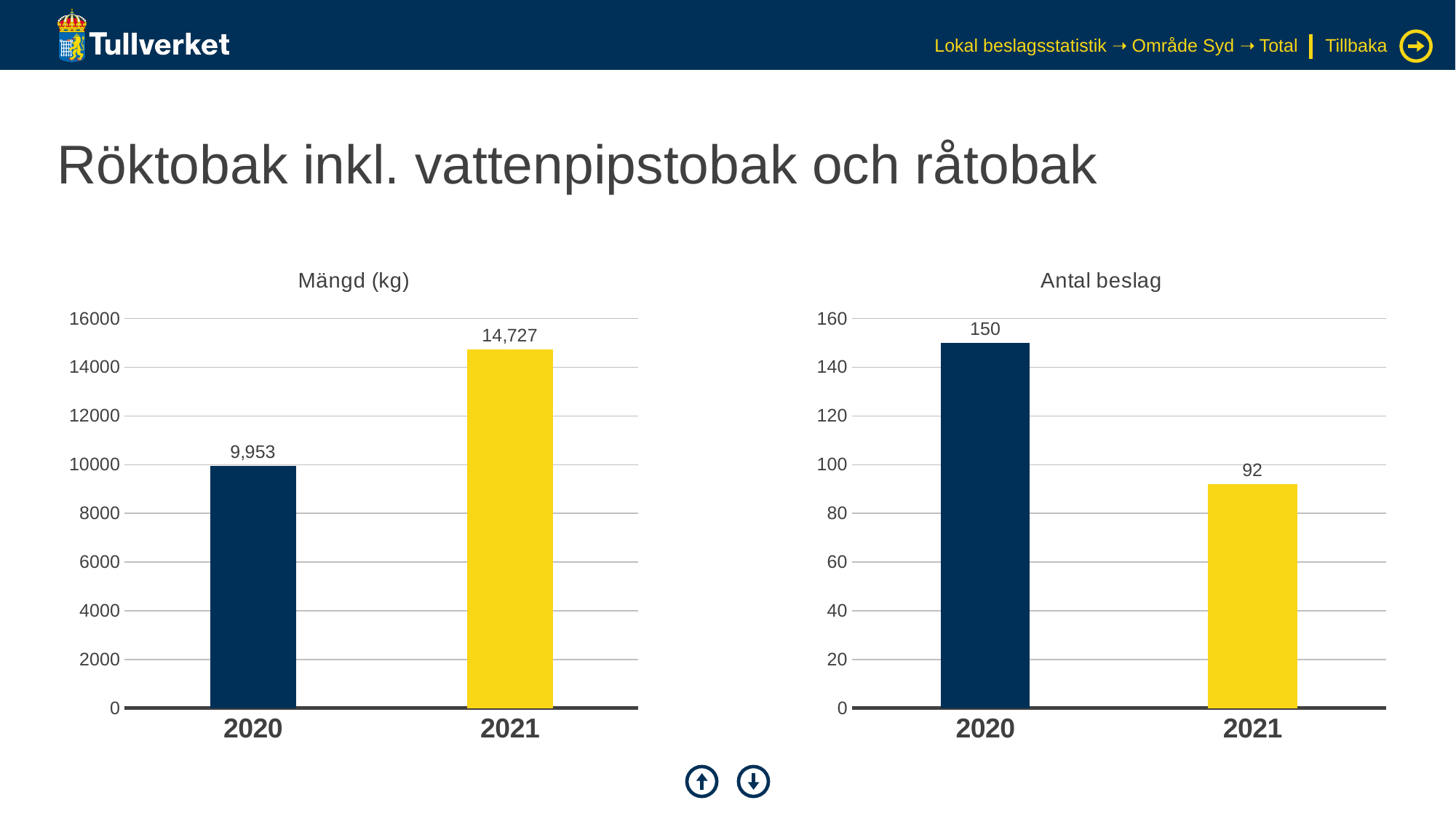
In the 'Antal beslag' chart, what is the value for 2020? 150 In the 'Mängd (kg)' chart, what is the value for 2020? 9,953 In the 'Mängd (kg)' chart, do the values rise or fall from 2020 to 2021? rise In the 'Antal beslag' chart, what is the value for 2021? 92 In the 'Mängd (kg)' chart, what is the value for 2021? 14,727 In the 'Antal beslag' chart, which year has the lowest value? 2021 In the 'Antal beslag' chart, what is the difference between the 2020 and 2021 values? 58 In the 'Mängd (kg)' chart, what is the difference between the 2021 and 2020 values? 4,774 What kind of chart is the 'Antal beslag' chart? bar chart How many categories are shown in the 'Mängd (kg)' chart? 2 In the 'Antal beslag' chart, is the value for 2020 greater or less than 140? greater In the 'Mängd (kg)' chart, which year has the highest value? 2021